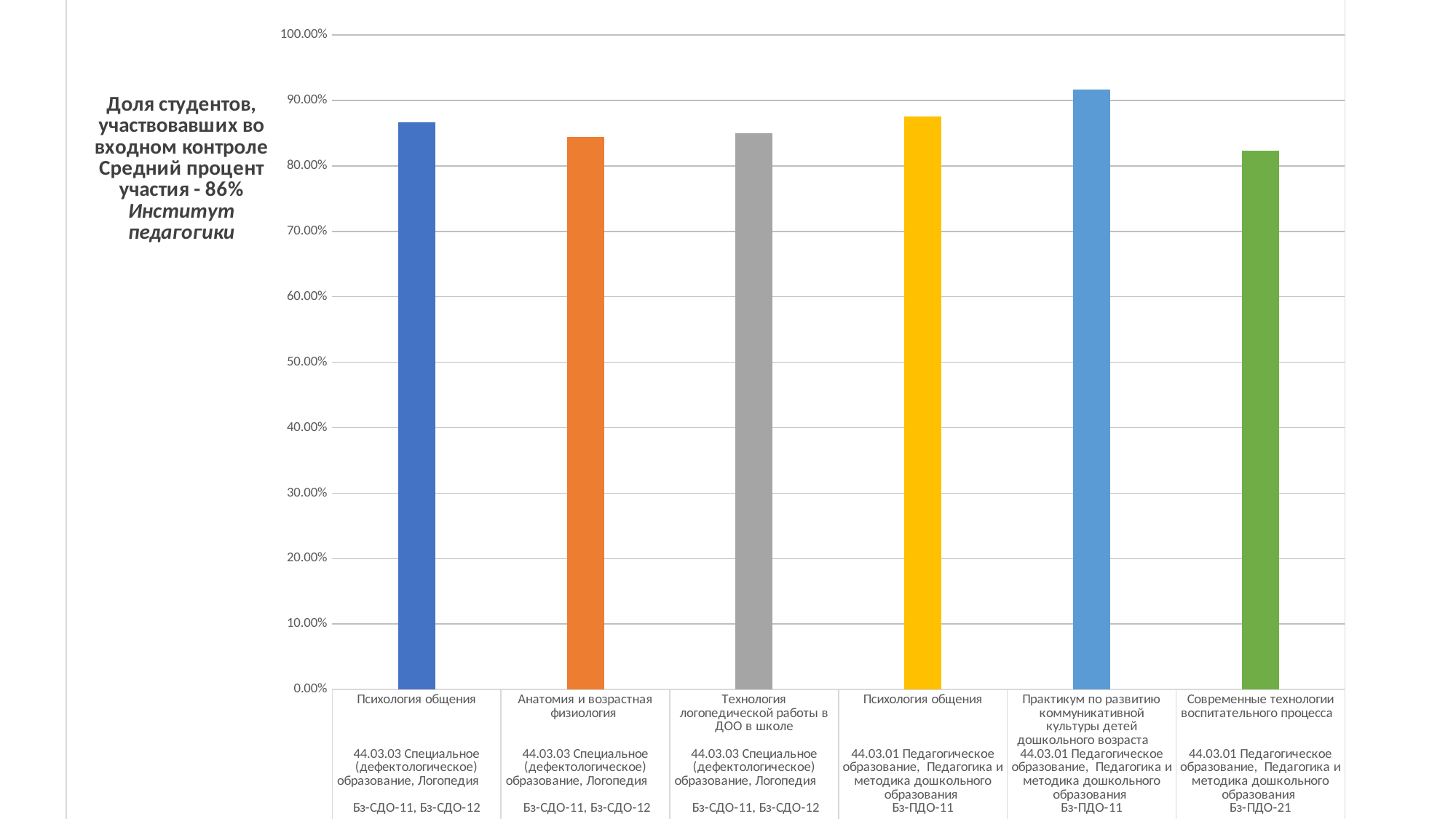
Is the value for Анатомия и возрастная физиология greater or less than 90.00%? less Is the value for Современные технологии воспитательного процесса greater or less than 80.00%? greater According to the text on the slide, what is the average participation percentage (Средний процент участия)? 86% Which is larger: the value for Психология общения (Бз-ПДО-11) or the value for Анатомия и возрастная физиология? Психология общения (Бз-ПДО-11) What colour is the bar for Анатомия и возрастная физиология? orange Which category has the highest bar? Практикум по развитию коммуникативной культуры детей дошкольного возраста Which is larger: the value for Практикум по развитию коммуникативной культуры детей дошкольного возраста or the value for Современные технологии воспитательного процесса? Практикум по развитию коммуникативной культуры детей дошкольного возраста Is the value for Практикум по развитию коммуникативной культуры детей дошкольного возраста greater or less than 90.00%? greater Which category has the lowest bar? Современные технологии воспитательного процесса What kind of chart is shown on the slide? bar chart How many bars (categories) does the chart show? 6